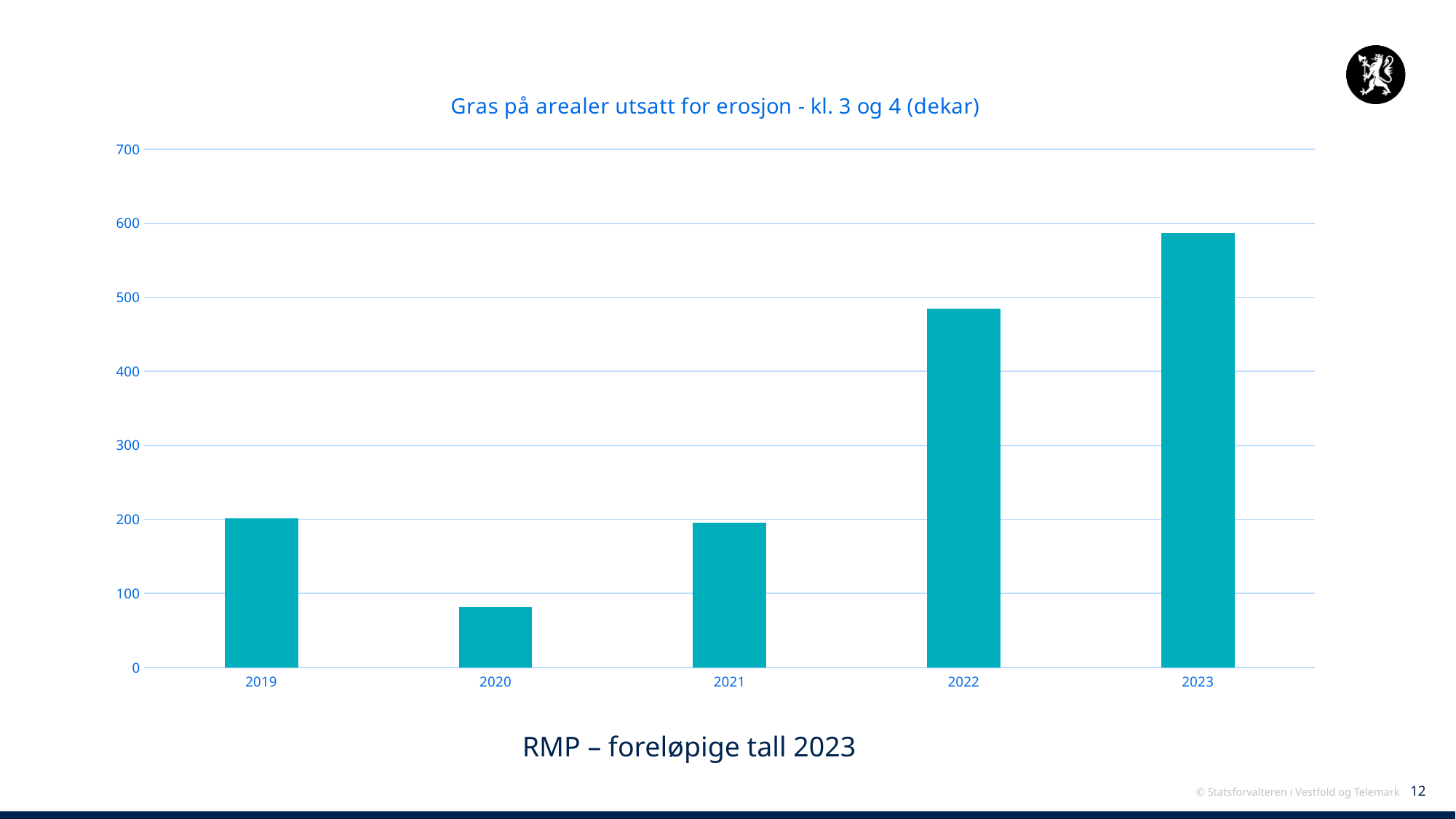
Which year has the larger value, 2020 or 2021? 2021 Is the value for 2020 greater or less than 100? less Is the value for 2021 greater or less than 300? less Which year has the highest value in the chart? 2023 What is the title of the chart? Gras på arealer utsatt for erosjon - kl. 3 og 4 (dekar) Is the value for 2023 greater or less than 500? greater Do the values rise or fall from 2021 to 2023? rise How many years are shown on the x axis of the chart? 5 Which year has the lowest value in the chart? 2020 Which year has the larger value, 2022 or 2023? 2023 What kind of chart is shown on the slide? bar chart